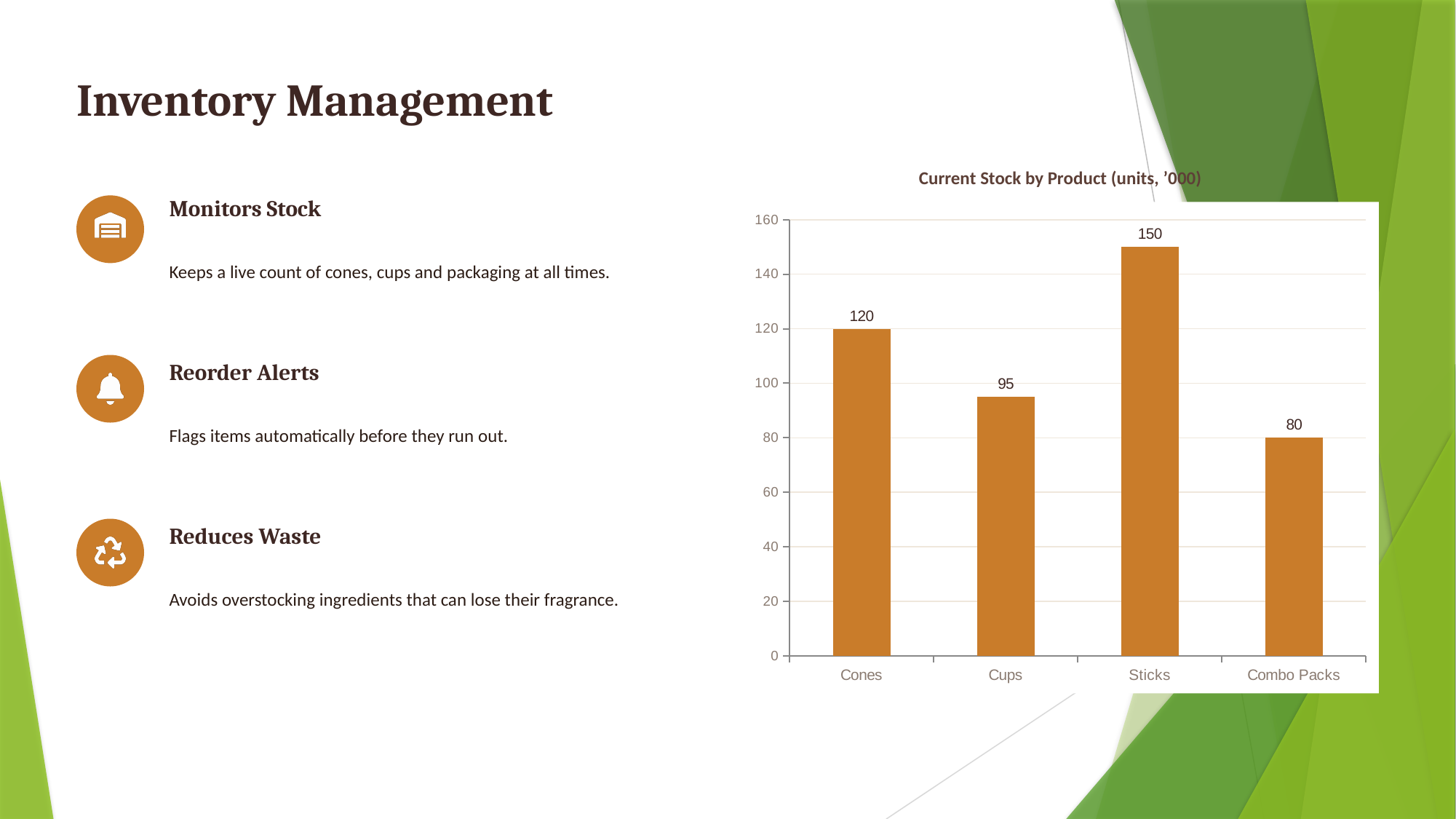
What is the difference between the values for Sticks and Cups? 55 How many product categories are shown on the chart? 4 What is the title of the chart? Current Stock by Product (units, '000) What is the value for Cones? 120 What kind of chart is shown on the slide? bar chart Is the value for Combo Packs greater or less than 100? less What is the value for Sticks? 150 What is the value for Combo Packs? 80 Which is larger, the value for Cones or the value for Cups? Cones Which product has the highest stock? Sticks Which product has the lowest stock? Combo Packs What is the value for Cups? 95